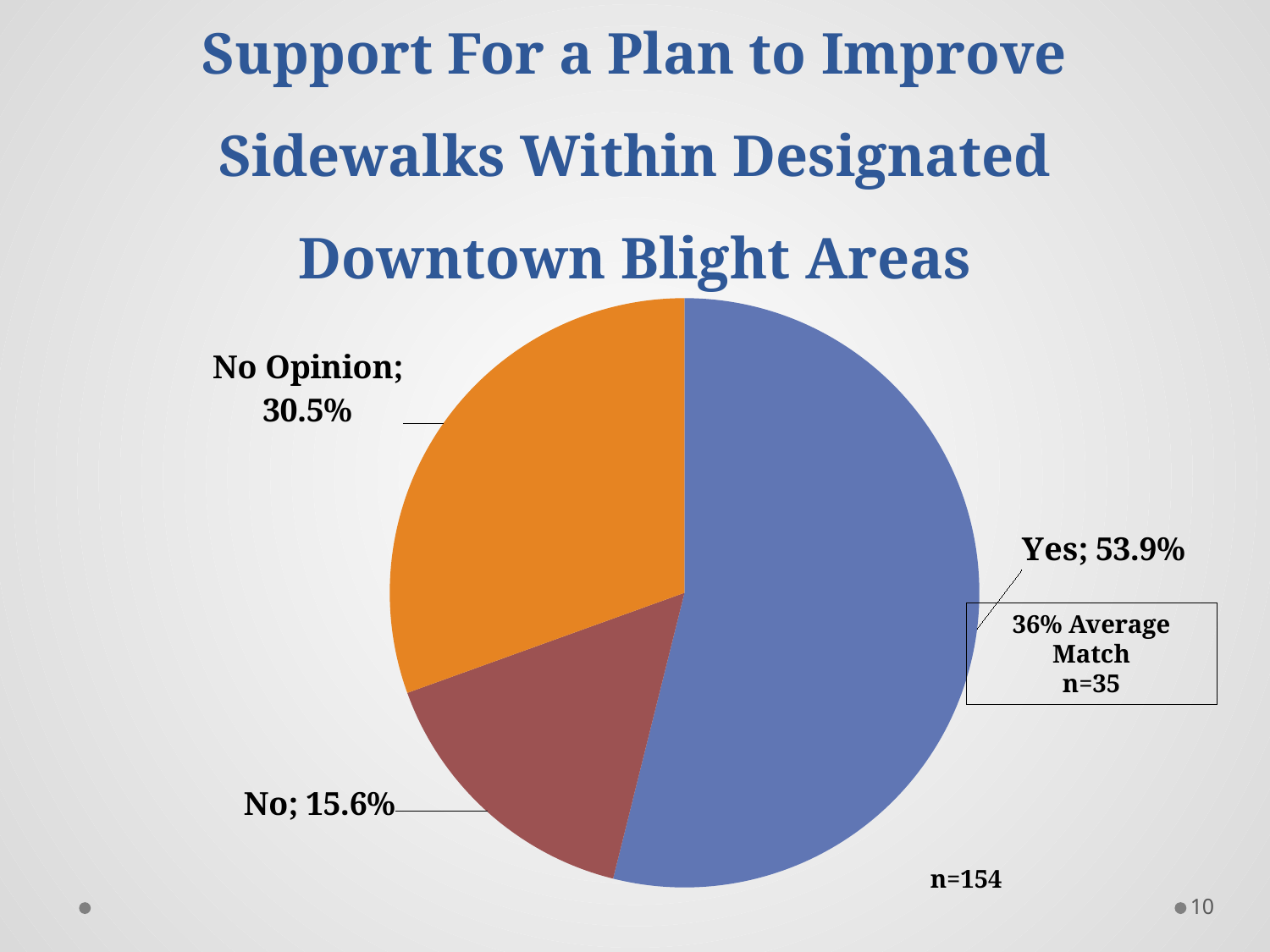
Which response has the smallest share of the pie? No How many slices does the pie chart have? 3 What is the difference in percentage points between No Opinion and No? 14.9 What percentage of respondents answered No? 15.6% What percentage of respondents answered Yes? 53.9% What kind of chart is shown on the slide? pie chart What percentage of respondents had No Opinion? 30.5% Which response has the largest share of the pie? Yes What colour is the Yes slice? blue Which is larger, the No Opinion share or the No share? No Opinion What is the sample size (n) shown for the chart? n=154 What is the difference in percentage points between Yes and No? 38.3